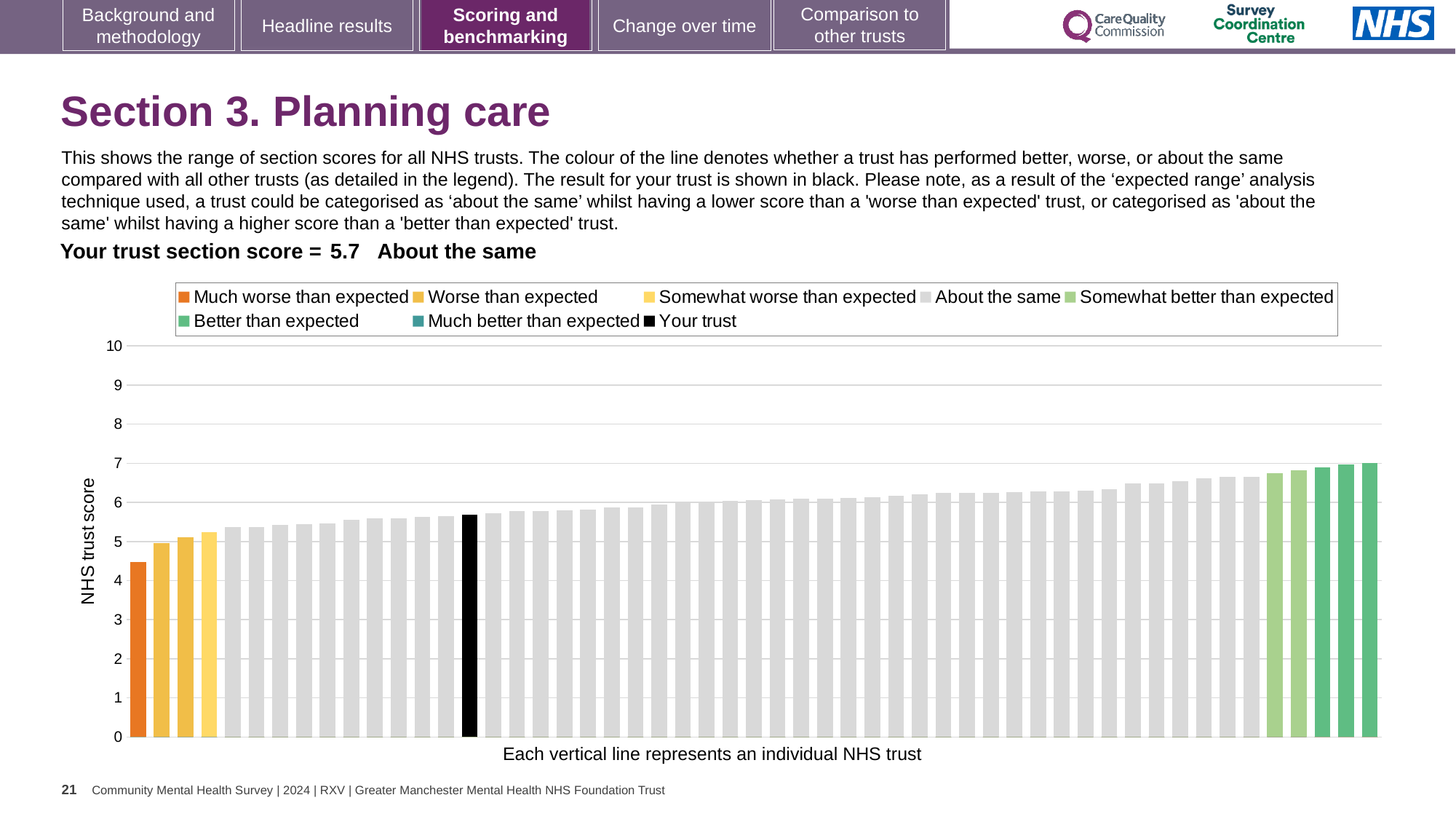
What colour is used for the bar representing your trust? black What kind of chart is shown on the slide? bar chart Which legend category does the lowest-scoring trust belong to? Much worse than expected Which legend category does the highest-scoring trust belong to? Better than expected Is the value of the black bar for your trust greater or less than 5? greater Is the value of the tallest bar greater or less than 6? greater Do the bar values rise or fall from left to right along the x axis? rise What is the label on the vertical axis of the chart? NHS trust score How many entries does the chart legend list? 8 What is the section score for your trust shown on the slide? 5.7 Which performance category is your trust placed in for Section 3. Planning care? About the same Is the value of the leftmost (orange) bar greater or less than 5? less